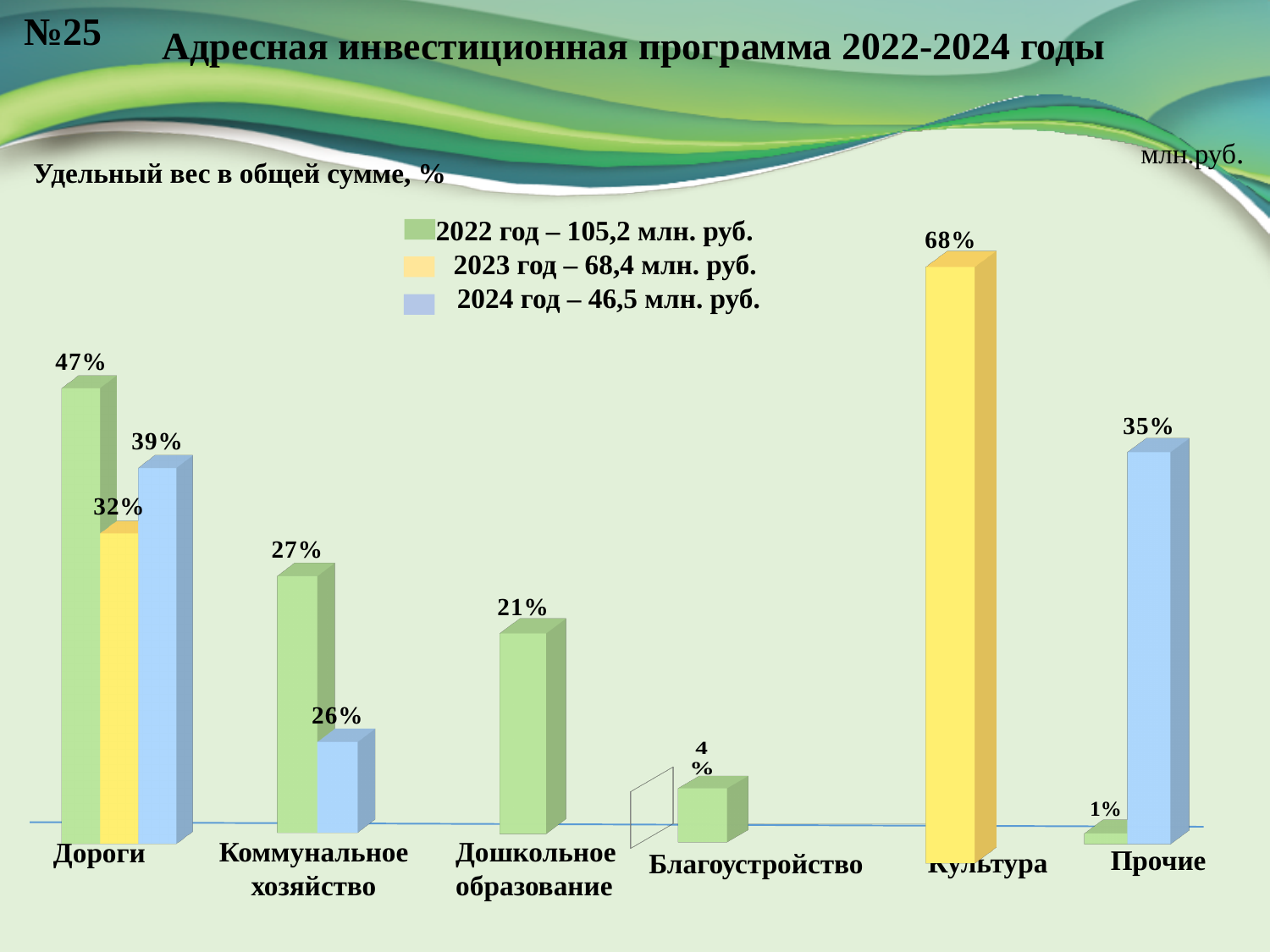
How many categories are shown on the x axis? 6 Which category has the highest 2022 share? Дороги How many series does the legend list? 3 What kind of chart is shown on the slide? bar chart Which is larger for Дороги: the 2024 share or the 2023 share? 2024 share According to the legend, what is the total amount for 2023? 68,4 млн. руб. What is the 2024 share for Прочие? 35% Which category has the lowest 2022 share? Прочие What is the 2023 share for Культура? 68% What is the difference between the 2022 and 2023 shares for Дороги? 15% What is the 2024 share for Коммунальное хозяйство? 26% What is the 2022 share for Дороги? 47%